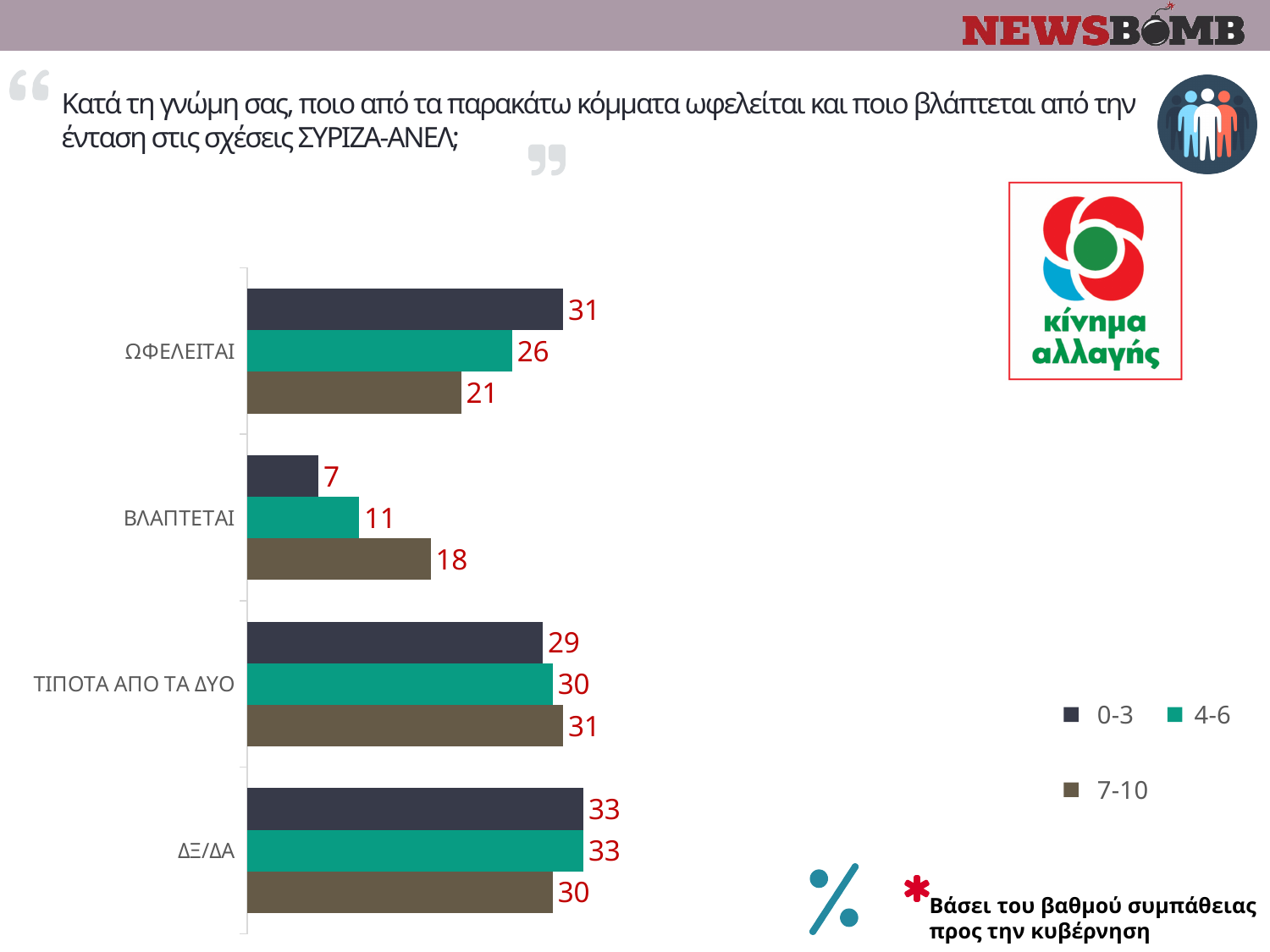
What is the value for ΒΛΑΠΤΕΤΑΙ in the 7-10 series? 18 What is the value for ΤΙΠΟΤΑ ΑΠΟ ΤΑ ΔΥΟ in the 4-6 series? 30 Which category has the lowest value in the 0-3 series? ΒΛΑΠΤΕΤΑΙ What is the value for ΔΞ/ΔΑ in the 7-10 series? 30 How many categories are shown on the chart? 4 What is the difference between the 0-3 and 7-10 values for ΩΦΕΛΕΙΤΑΙ? 10 Which category has the highest value in the 4-6 series? ΔΞ/ΔΑ How many series does the legend list? 3 Which colour represents the 4-6 series in the legend? Green What kind of chart is shown on the slide? Bar chart For ΒΛΑΠΤΕΤΑΙ, which series has the larger value, 0-3 or 4-6? 4-6 What is the value for ΩΦΕΛΕΙΤΑΙ in the 0-3 series? 31